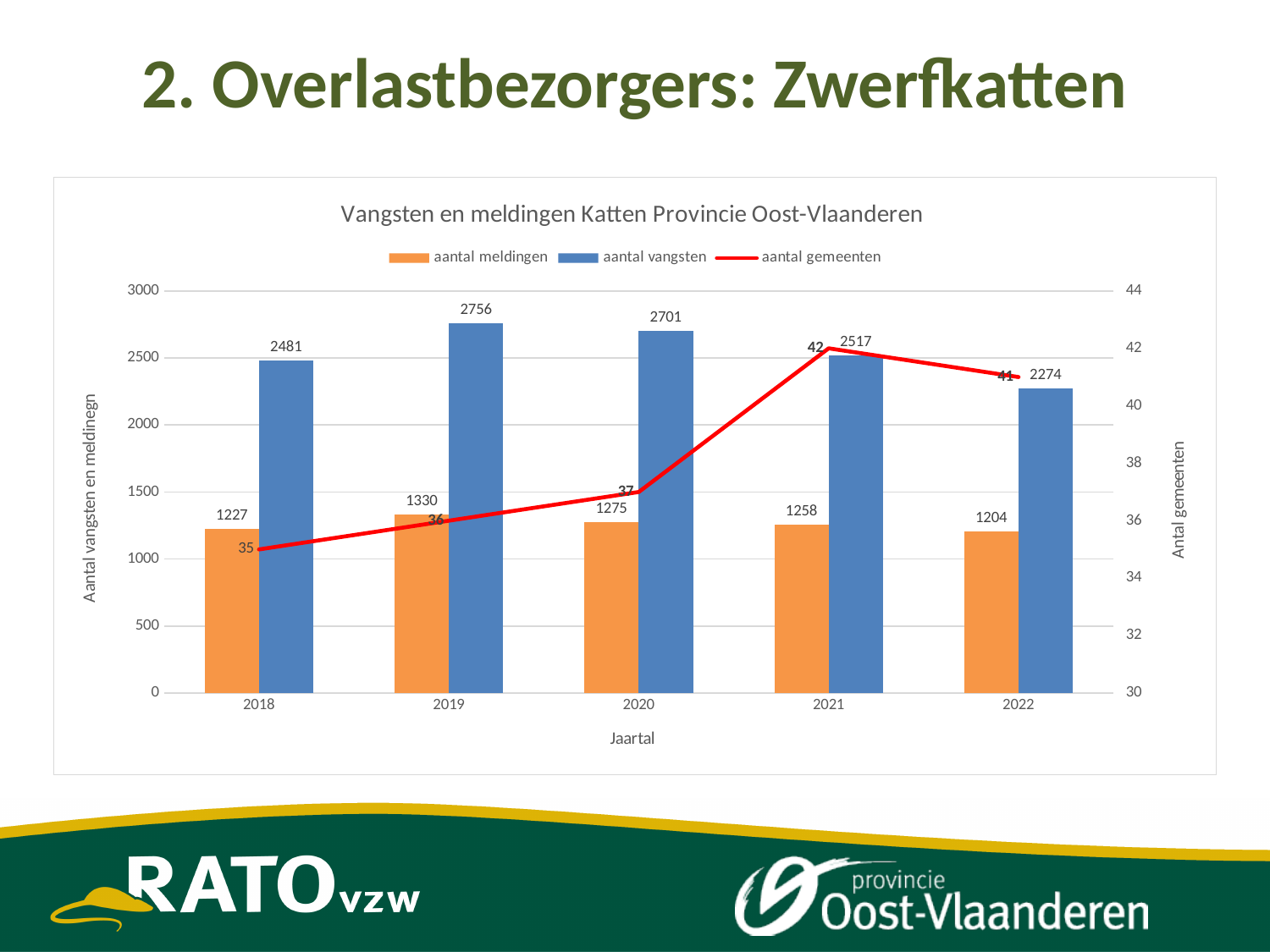
What is the value of aantal vangsten for 2019? 2756 Which year has the lowest aantal meldingen? 2022 What is the title of the chart? Vangsten en meldingen Katten Provincie Oost-Vlaanderen How many years are shown on the x axis? 5 How many series does the legend list? 3 What is the difference between aantal vangsten in 2019 and 2022? 482 Is the value of aantal vangsten for 2018 greater or less than 2500? less Does aantal gemeenten rise or fall from 2018 to 2021? rise Which is larger, aantal meldingen in 2019 or in 2020? 2019 What is the value of aantal meldingen for 2022? 1204 What is the value of aantal gemeenten for 2021? 42 Which year has the highest aantal vangsten? 2019